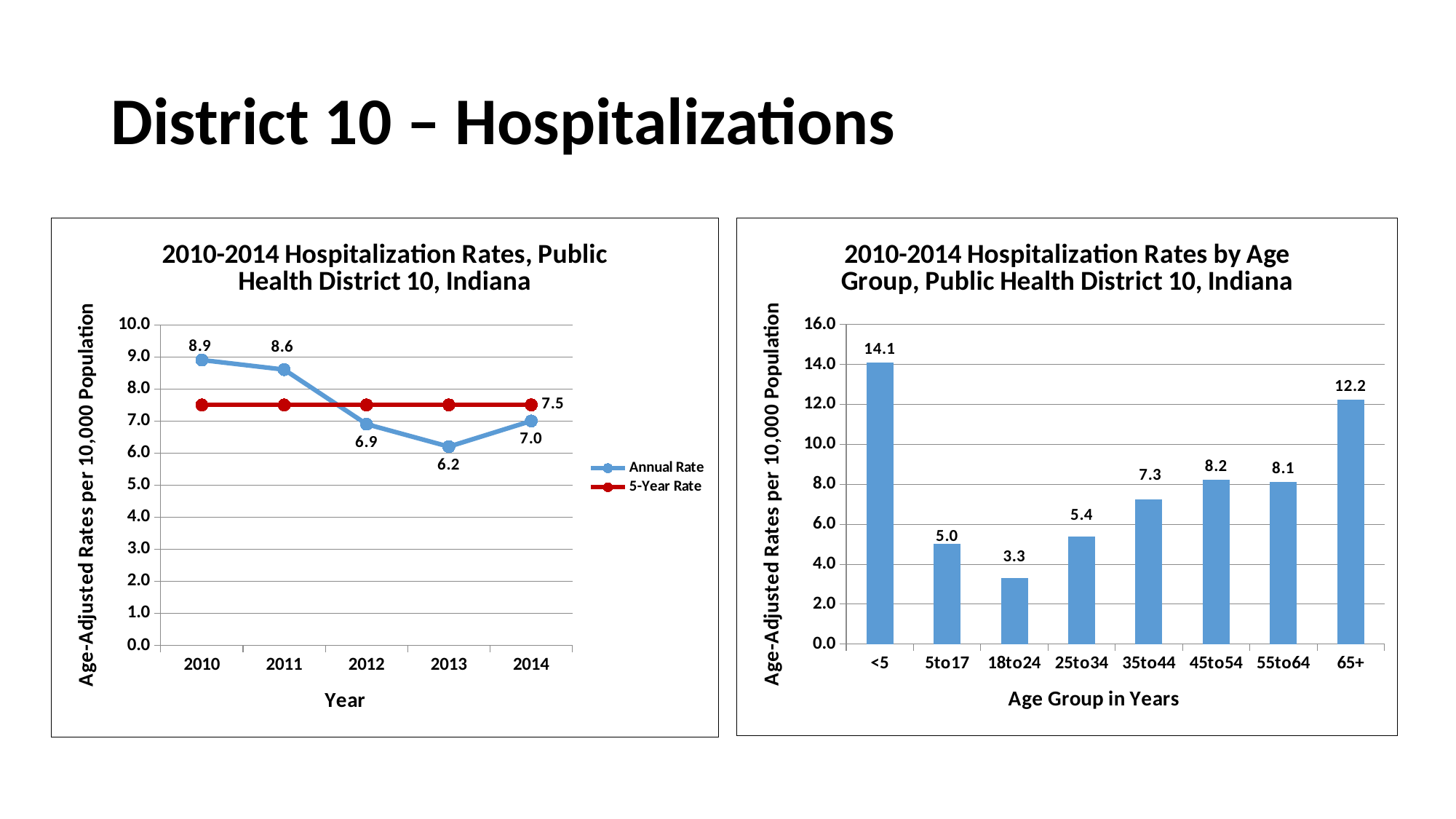
In the left chart (2010-2014 Hospitalization Rates, Public Health District 10), how many series does the legend list? 2 In the left chart (2010-2014 Hospitalization Rates, Public Health District 10), what is the difference between the annual rates for 2010 and 2014? 1.9 In the left chart (2010-2014 Hospitalization Rates, Public Health District 10), which year has the lowest annual rate? 2013 In the left chart (2010-2014 Hospitalization Rates, Public Health District 10), what is the 5-Year Rate? 7.5 In the left chart (2010-2014 Hospitalization Rates, Public Health District 10), what is the annual rate for 2010? 8.9 In the right chart (2010-2014 Hospitalization Rates by Age Group), which age group has the highest rate? <5 In the left chart (2010-2014 Hospitalization Rates, Public Health District 10), what is the annual rate for 2013? 6.2 In the right chart (2010-2014 Hospitalization Rates by Age Group), what is the rate for the 18to24 age group? 3.3 In the right chart (2010-2014 Hospitalization Rates by Age Group), how many age groups are shown? 8 In the left chart (2010-2014 Hospitalization Rates, Public Health District 10), what kind of chart is it? Line chart In the right chart (2010-2014 Hospitalization Rates by Age Group), what is the difference between the rates for <5 and 65+? 1.9 In the right chart (2010-2014 Hospitalization Rates by Age Group), which is larger, the rate for 45to54 or 35to44? 45to54